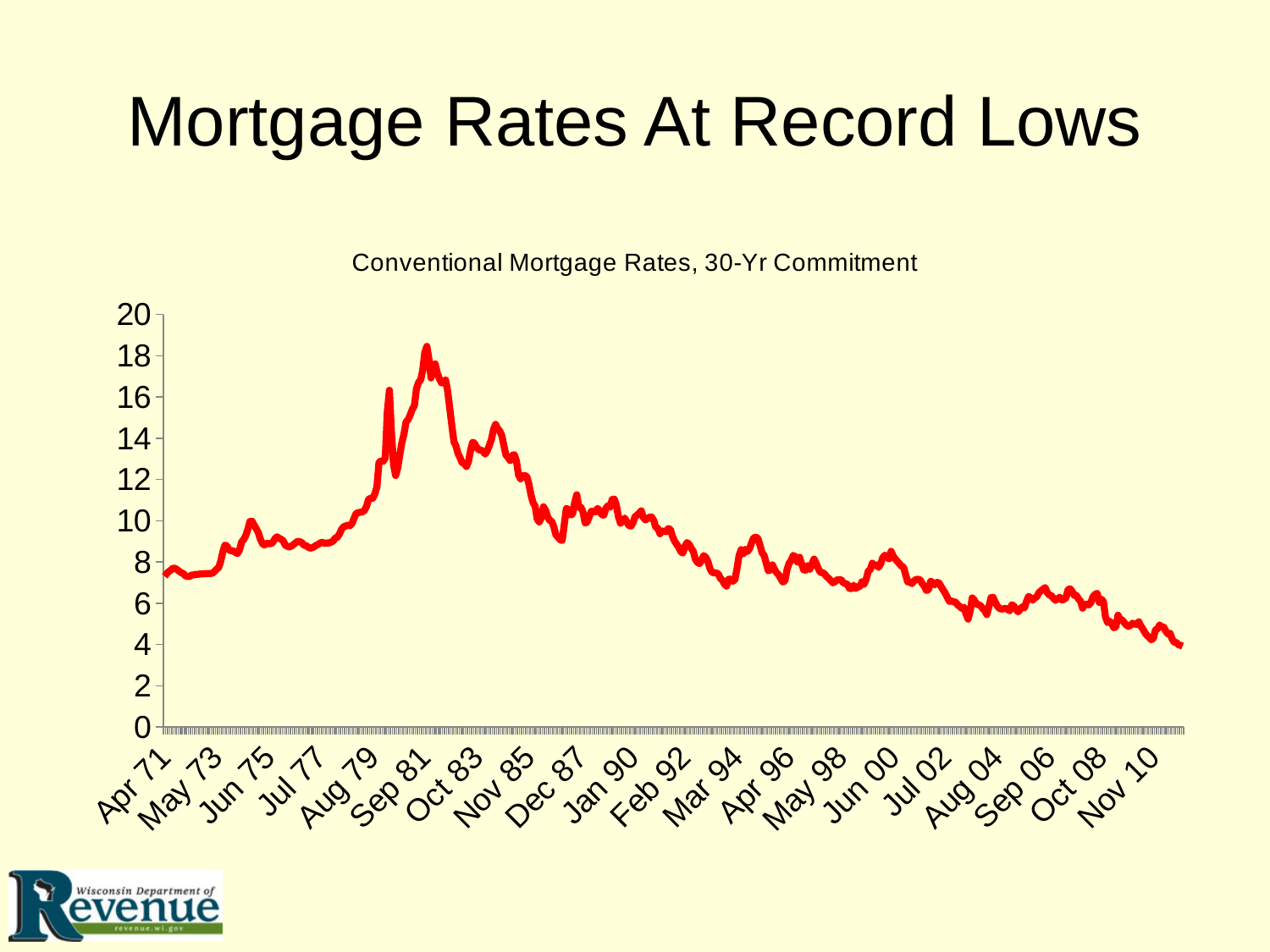
Around which labeled date does the mortgage rate reach its peak? Sep 81 Which is higher, the mortgage rate at Sep 81 or at Nov 10? Sep 81 Do mortgage rates generally rise or fall from Sep 81 to Nov 10? fall Is the mortgage rate at Aug 04 greater or less than 8? less What is the title of the chart? Conventional Mortgage Rates, 30-Yr Commitment Is the mortgage rate at Sep 81 greater or less than 14? greater How many date labels are shown along the x axis? 20 Is the mortgage rate at Nov 10 greater or less than 6? less What kind of chart is shown on the slide? line chart What is the highest value shown on the vertical axis? 20